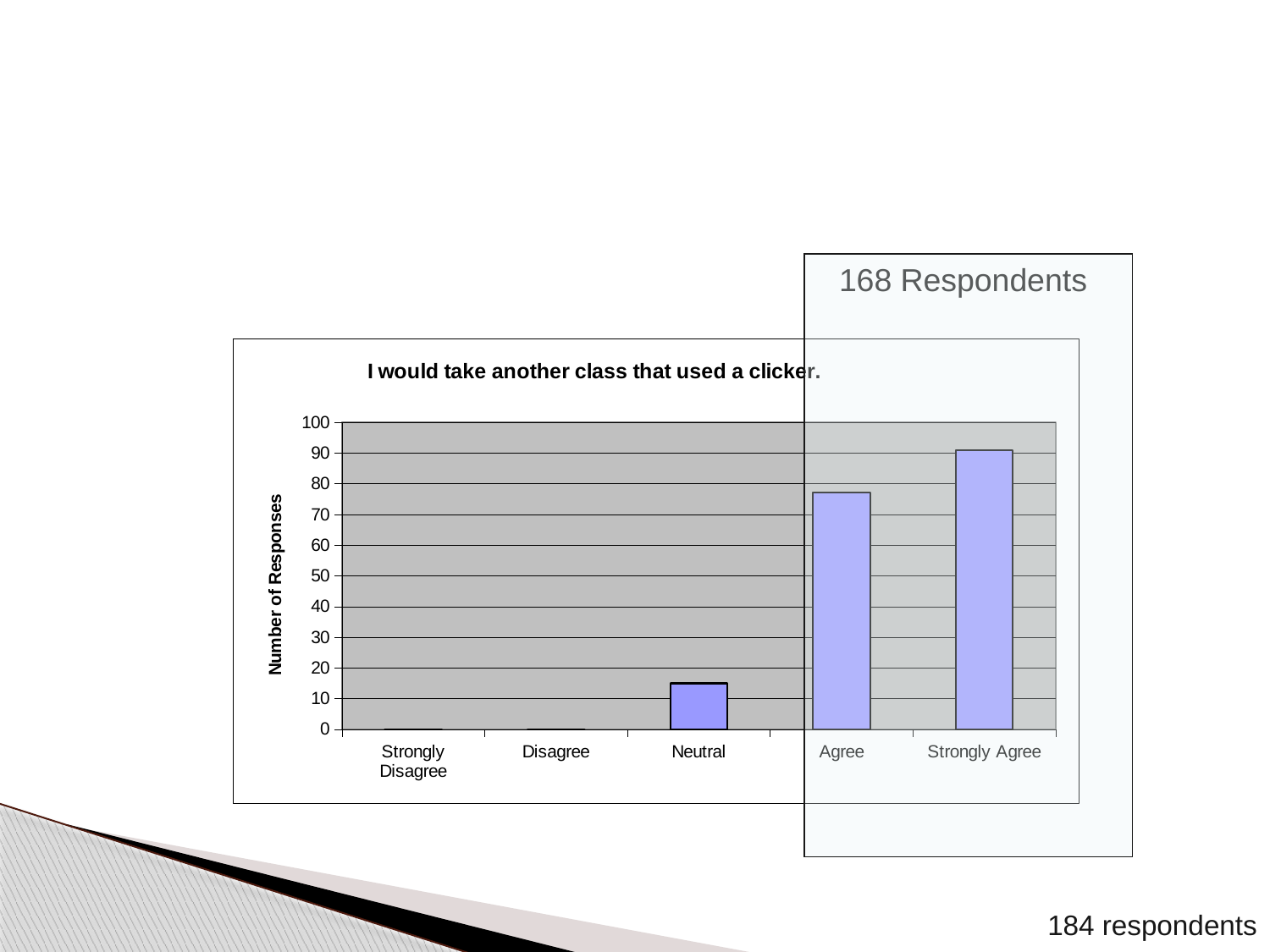
Which has more responses, Agree or Strongly Agree? Strongly Agree What kind of chart is shown on the slide? bar chart What is the label on the vertical axis of the chart? Number of Responses Which category has the highest number of responses? Strongly Agree Is the value for Agree greater or less than 70? greater Do the values rise or fall moving from Strongly Disagree to Strongly Agree along the x axis? rise Is the value for Neutral greater or less than 20? less Which has more responses, Neutral or Agree? Agree Is the value for Strongly Agree greater or less than 80? greater How many response categories are shown on the x axis of the chart? 5 What is the title of the chart? I would take another class that used a clicker.